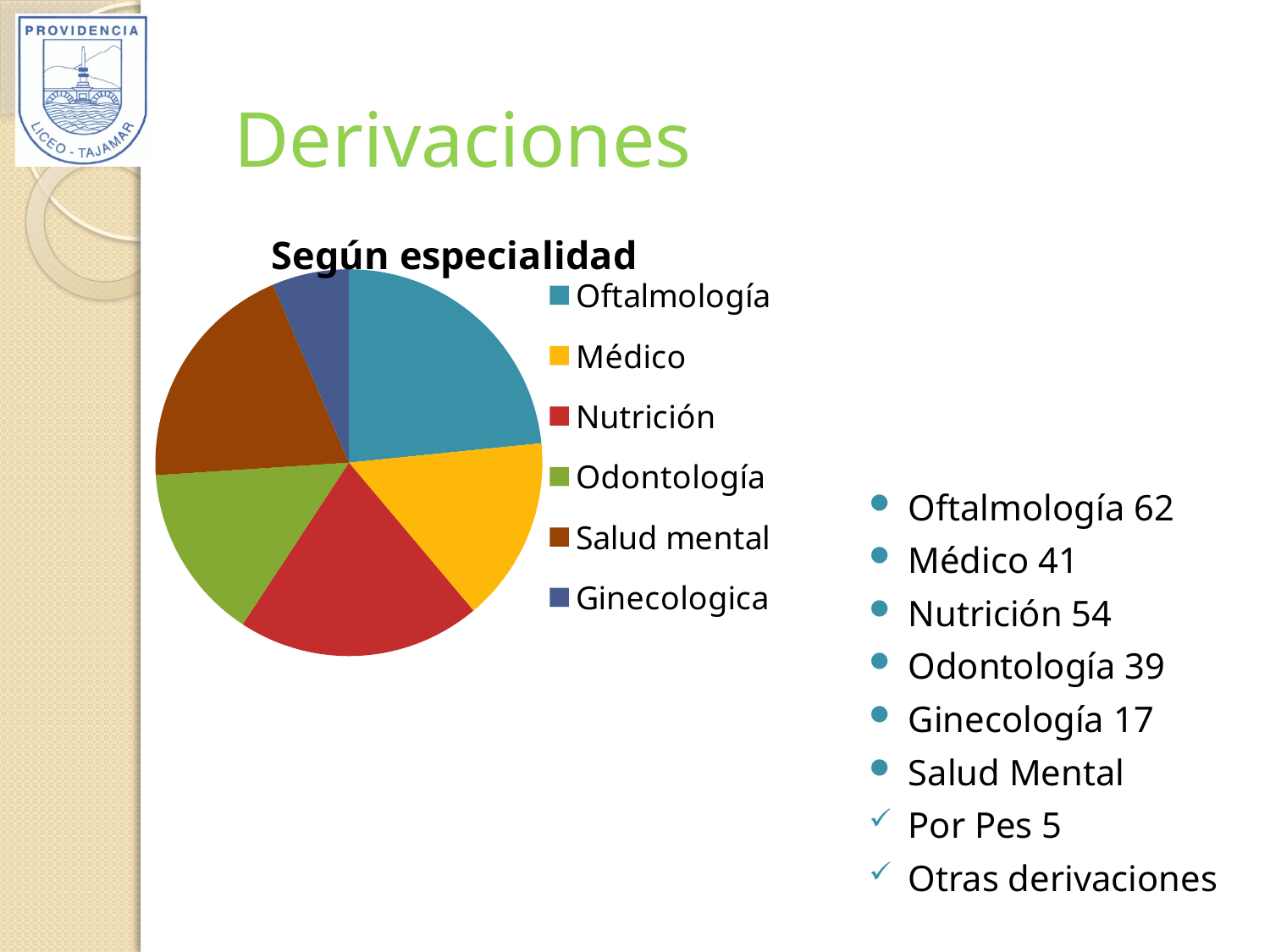
What is the title of the chart? Según especialidad According to the slide, what is the value for Oftalmología? 62 What is the difference between the values for Oftalmología and Médico? 21 How many categories does the pie chart have? 6 Which category has the largest slice of the pie? Oftalmología According to the slide, what is the value for Ginecología? 17 According to the slide, what is the value for Nutrición? 54 Which is larger, the slice for Odontología or the slice for Ginecologica? Odontología Which is larger, the slice for Oftalmología or the slice for Médico? Oftalmología Which category has the smallest slice of the pie? Ginecologica What kind of chart is shown on the slide? pie chart What colour is the Salud mental slice in the pie chart? brown